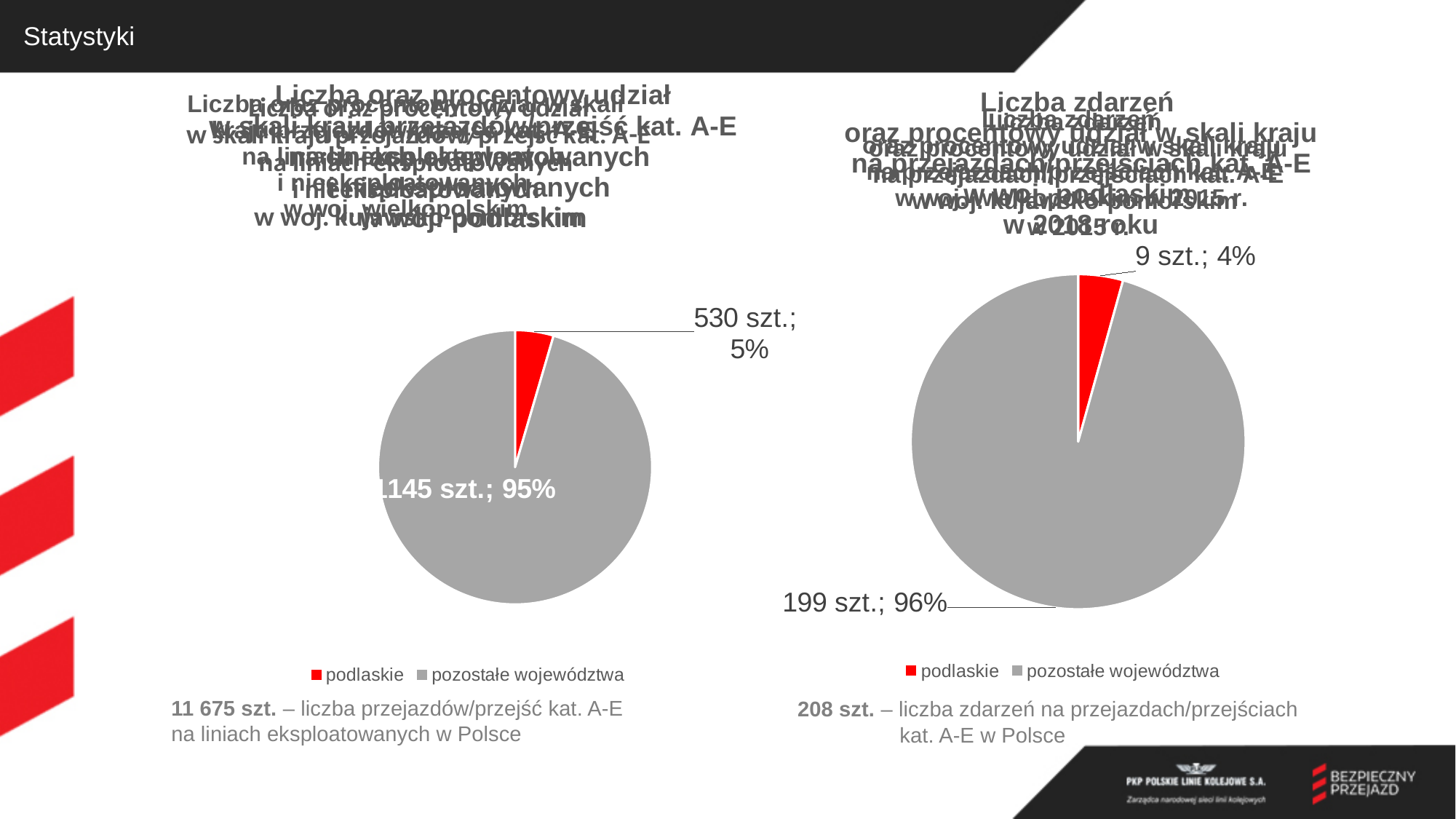
In the right pie chart, what value is shown for pozostałe województwa? 199 szt. In the left pie chart, which category has the smallest slice? podlaskie In the right pie chart, what value is shown for podlaskie? 9 szt. In the right pie chart, what share of the pie does podlaskie have? 4% What kind of chart is the left chart on the slide? pie chart In the right pie chart, what is the difference between the values for pozostałe województwa and podlaskie? 190 szt. In the left pie chart, what share of the pie does pozostałe województwa have? 95% In the right pie chart, which category has the largest slice? pozostałe województwa How many entries does the legend of the left pie chart list? 2 In the right pie chart, what is the total of the two slices? 208 szt. In the left pie chart, what share of the pie does podlaskie have? 5% In the left pie chart, what value is shown for podlaskie? 530 szt.